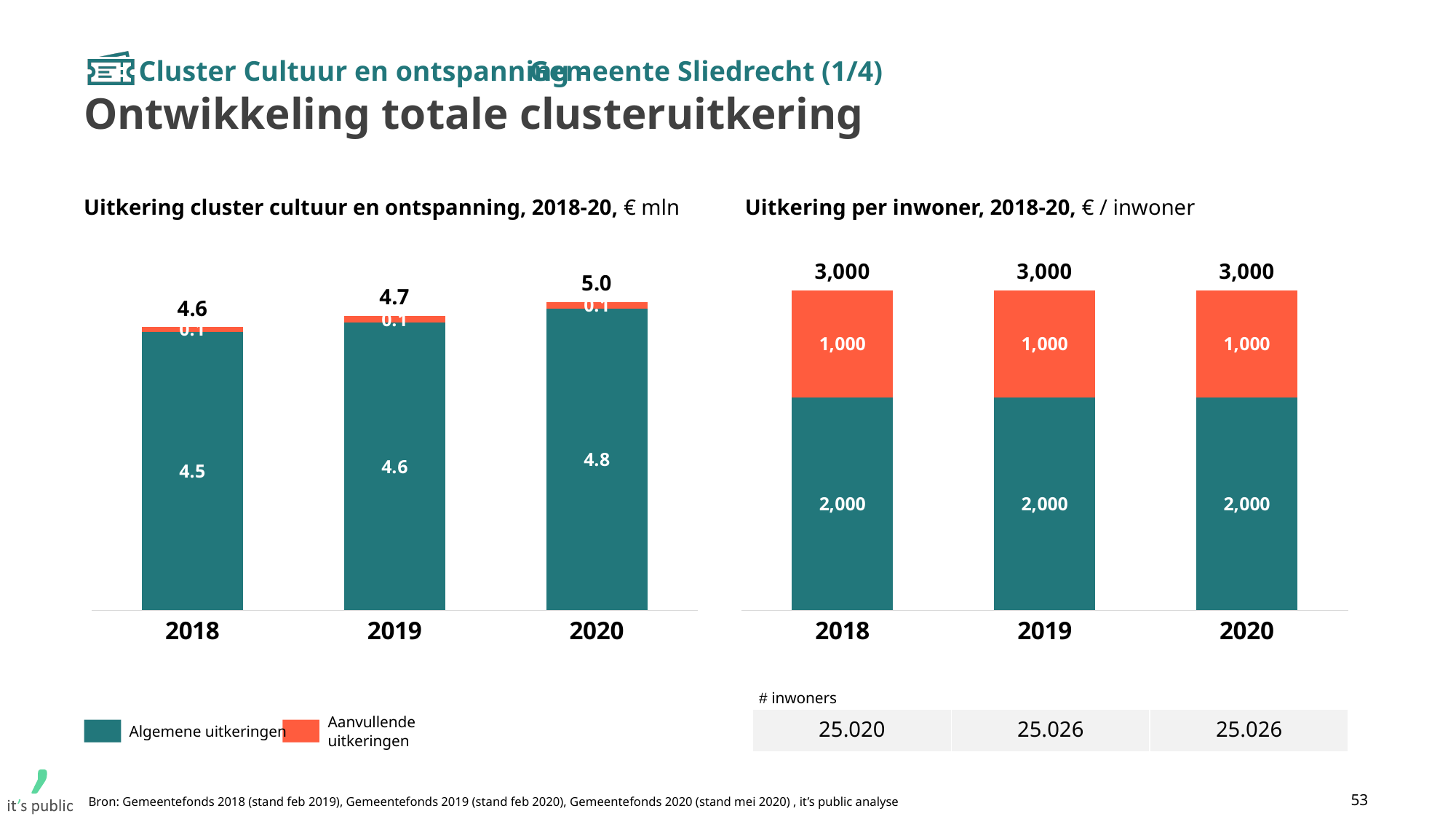
How many series does the legend list for the charts on this slide? 2 In the right chart (Uitkering per inwoner), what is the value of Algemene uitkeringen in 2019? 2,000 In the left chart (Uitkering cluster cultuur en ontspanning), what is the difference between the Algemene uitkeringen in 2020 and in 2018? 0.3 In the right chart (Uitkering per inwoner), what is the total uitkering per inwoner in 2018? 3,000 In the left chart (Uitkering cluster cultuur en ontspanning), what is the value of Algemene uitkeringen in 2018? 4.5 In the left chart (Uitkering cluster cultuur en ontspanning), which year has the highest total uitkering? 2020 How many years are shown on the x axis of the left chart (Uitkering cluster cultuur en ontspanning)? 3 In the left chart (Uitkering cluster cultuur en ontspanning), which year has the lowest total uitkering? 2018 In the left chart (Uitkering cluster cultuur en ontspanning), what is the value of Aanvullende uitkeringen in 2019? 0.1 In the left chart (Uitkering cluster cultuur en ontspanning), what is the total uitkering for 2020? 5.0 In the left chart (Uitkering cluster cultuur en ontspanning), do the total values rise or fall from 2018 to 2020? rise In the right chart (Uitkering per inwoner), is the Aanvullende uitkeringen value in 2020 larger or smaller than the Algemene uitkeringen value in 2020? smaller